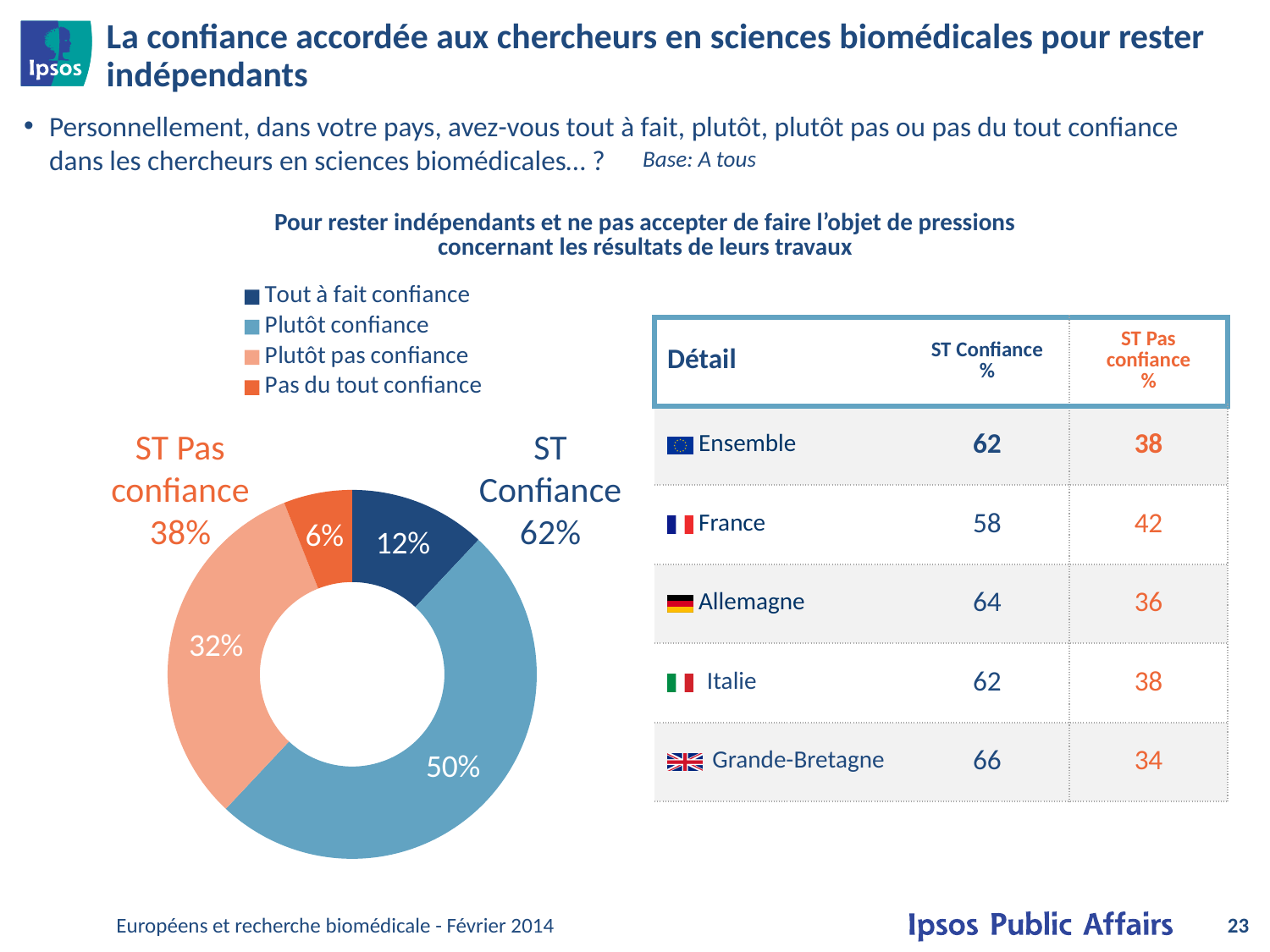
What percentage of respondents answered "Plutôt confiance"? 50% What percentage of respondents answered "Tout à fait confiance"? 12% Which is larger: the share for "Tout à fait confiance" or the share for "Pas du tout confiance"? Tout à fait confiance What is the difference between the "Plutôt confiance" share and the "Plutôt pas confiance" share? 18 percentage points What is the combined share labelled "ST Confiance" next to the pie chart? 62% What is the combined share labelled "ST Pas confiance" next to the pie chart? 38% Which response category has the smallest share of the pie? Pas du tout confiance What percentage of respondents answered "Pas du tout confiance"? 6% Which response category has the largest share of the pie? Plutôt confiance How many response categories does the legend of the pie chart list? 4 What percentage of respondents answered "Plutôt pas confiance"? 32% What kind of chart is shown on the slide? Pie chart (donut)